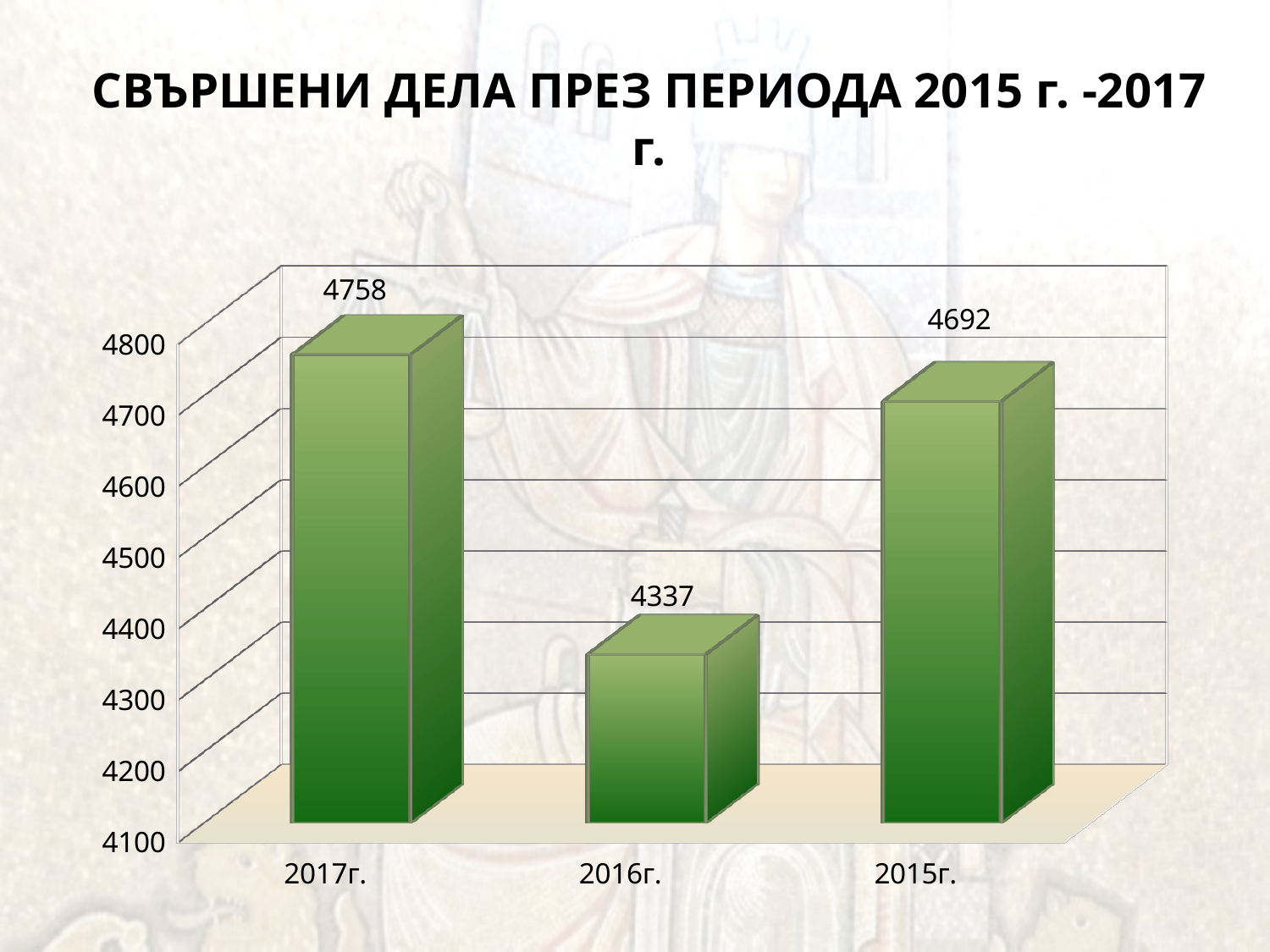
Which year has the highest value? 2017г. What is the value for 2015г.? 4692 What is the difference between the values for 2015г. and 2016г.? 355 What is the difference between the values for 2017г. and 2015г.? 66 What is the title of the chart? СВЪРШЕНИ ДЕЛА ПРЕЗ ПЕРИОДА 2015 г. -2017 г. Which year has the lowest value? 2016г. What kind of chart is shown on the slide? bar chart What is the value for 2017г.? 4758 Is the value for 2016г. greater or less than 4400? less What is the value for 2016г.? 4337 Which is larger, the value for 2016г. or the value for 2015г.? 2015г. How many categories are shown on the x axis? 3